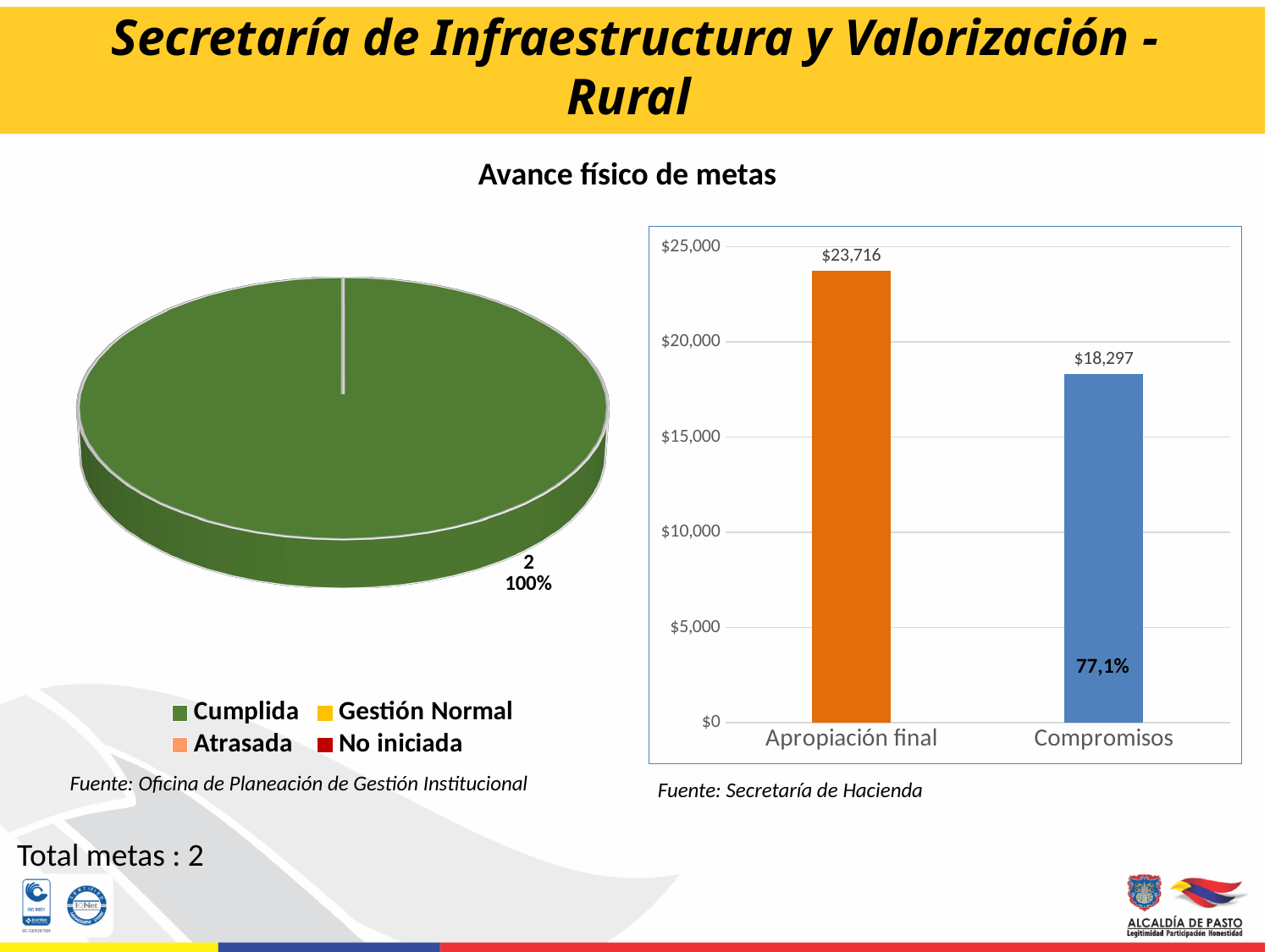
What kind of chart is shown on the right side of the slide? bar chart In the bar chart on the right, what percentage label is printed on the Compromisos bar? 77,1% In the bar chart on the right, what is the value for Compromisos? $18,297 In the bar chart on the right, is the value for Compromisos greater or less than $20,000? less What kind of chart is shown on the left side of the slide? pie chart In the pie chart on the left, what share does the Cumplida slice have? 100% In the bar chart on the right, how many categories are shown on the x axis? 2 In the bar chart on the right, what is the value for Apropiación final? $23,716 In the bar chart on the right, which category has the higher value? Apropiación final In the bar chart on the right, what is the difference between Apropiación final and Compromisos? $5,419 In the bar chart on the right, which category has the lower value? Compromisos In the pie chart on the left, how many entries does the legend list? 4